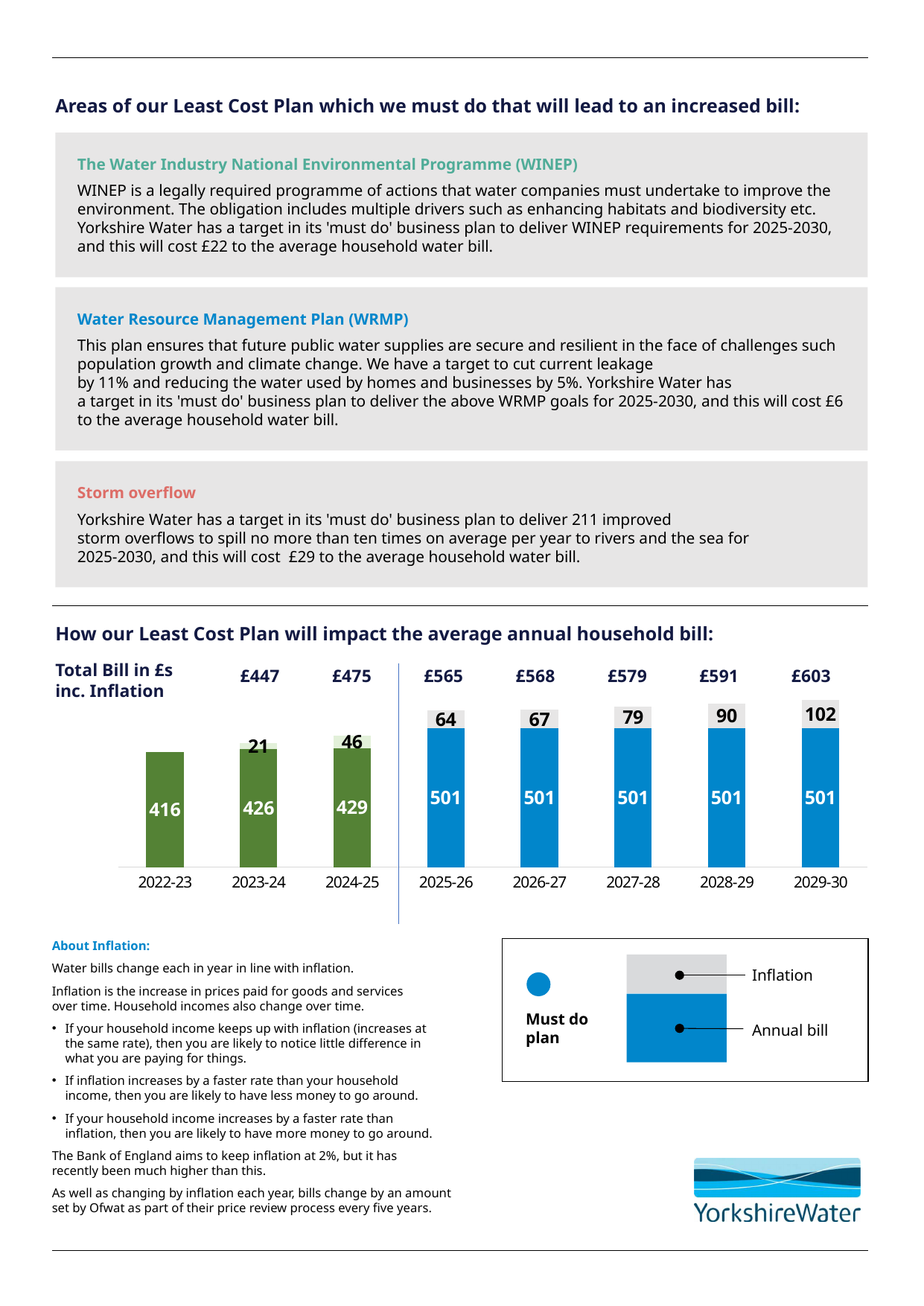
Which year has the lowest inflation value among those labelled? 2023-24 How many years are shown on the x axis? 8 What is the annual bill value for 2022-23? 416 Is the inflation value larger for 2027-28 or 2026-27? 2027-28 Do the total bill values rise or fall from 2023-24 to 2029-30? Rise What is the annual bill value for 2025-26? 501 What is the difference between the total bill for 2029-30 and 2025-26? £38 Which year has the highest total bill? 2029-30 What is the total bill shown above the bar for 2024-25? £475 How many series does the legend list? 2 What kind of chart is used to show the household bill? Stacked bar chart What is the inflation value shown for 2029-30? 102